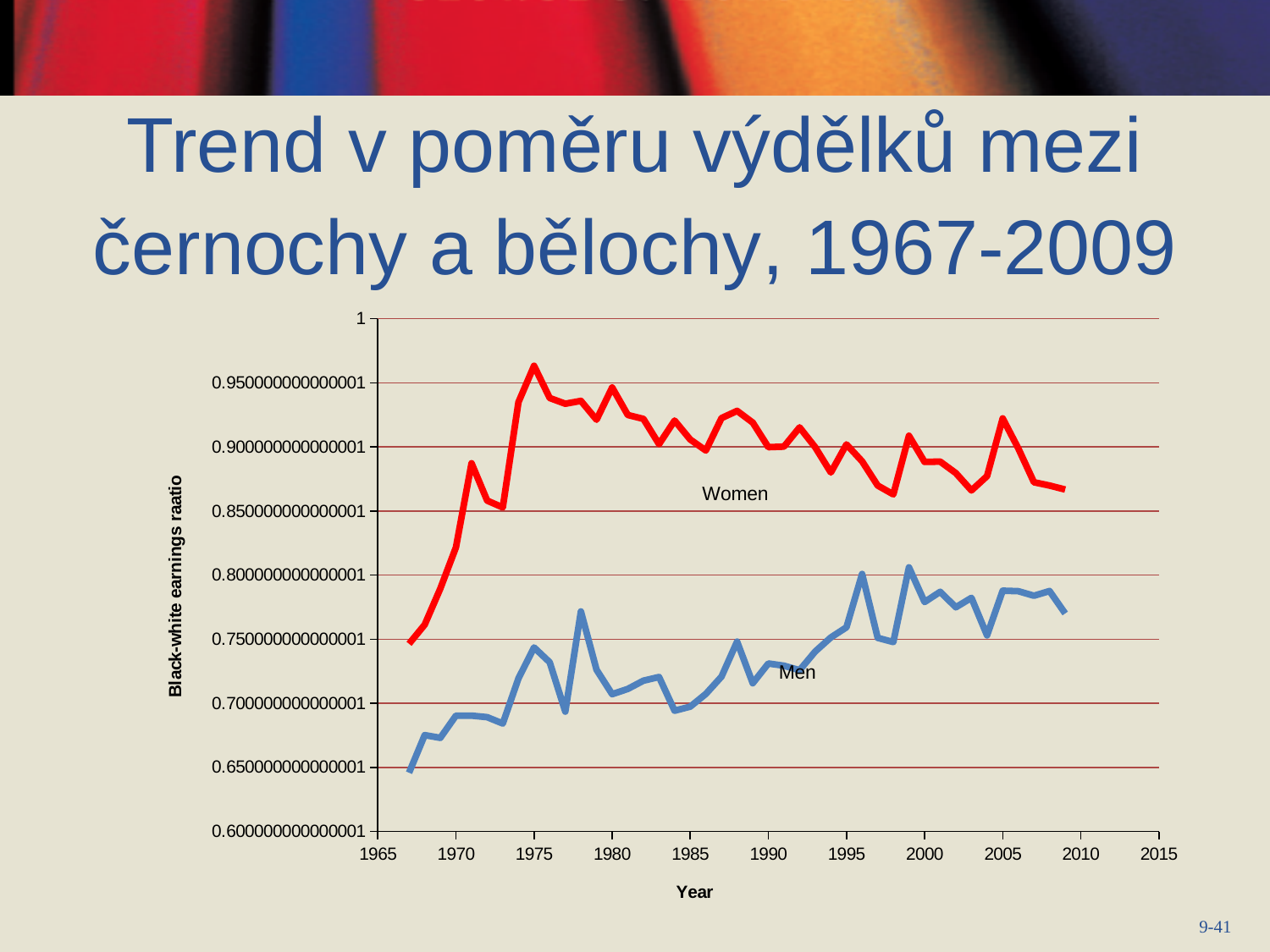
What is the label of the x axis? Year Is the value for Men in 2005 greater or less than 0.75? greater What kind of chart is shown on the slide? line chart Is the value for Women in 1970 greater or less than 0.75? greater Which two series are labelled on the chart? Women and Men In 1990, which series has the higher value, Women or Men? Women Is the value for Men in 1985 greater or less than 0.75? less Does the Women series rise or fall between 1975 and 2009? fall How many series are plotted on the chart? 2 Does the Men series overall rise or fall from 1967 to 2009? rise